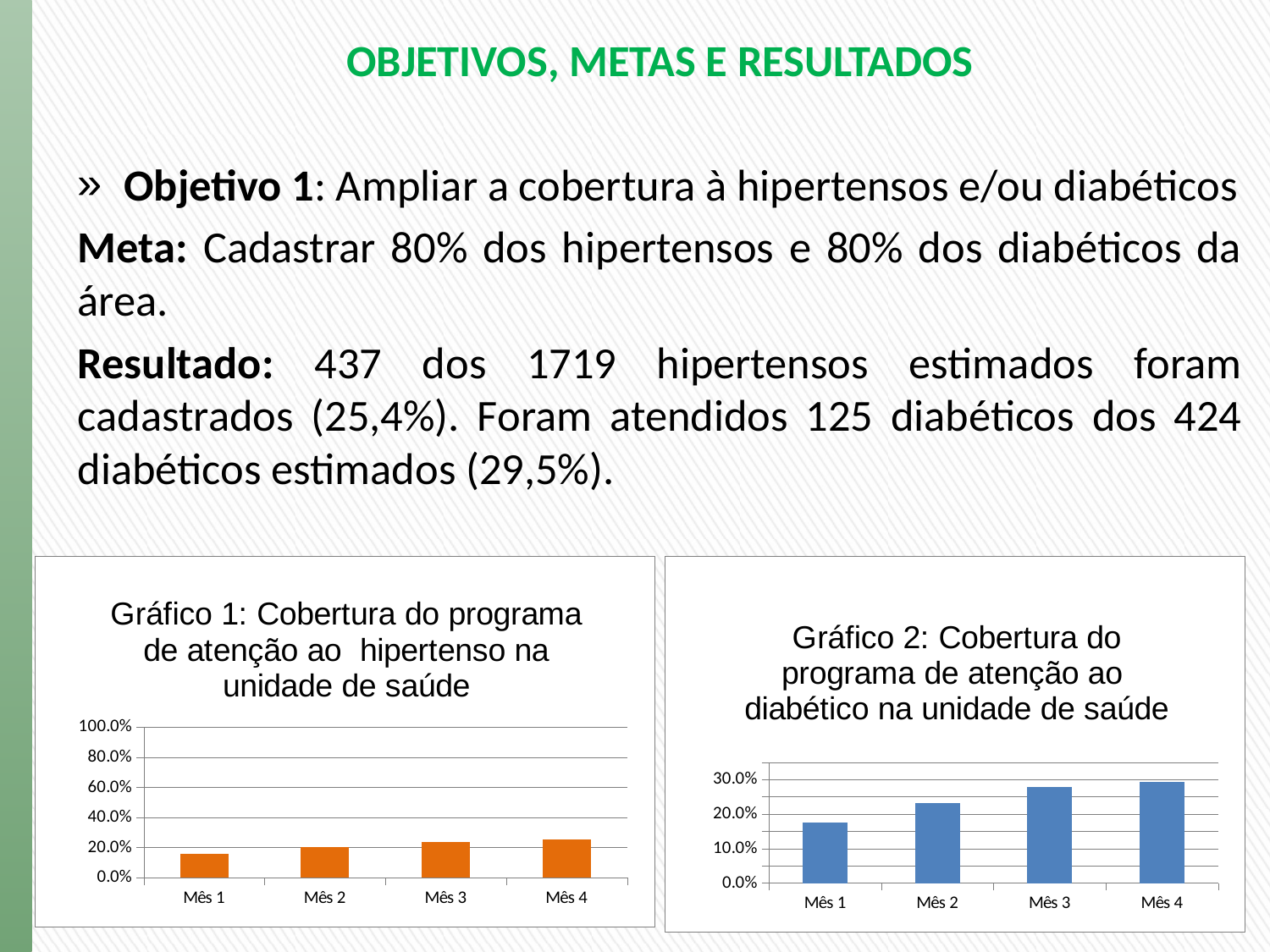
In Gráfico 2 (diabético), which month has the highest coverage? Mês 4 In Gráfico 2 (diabético), is the value for Mês 1 greater or less than 20.0%? less What kind of chart is Gráfico 1 (Cobertura do programa de atenção ao hipertenso)? bar chart What colour are the bars in Gráfico 1 (hipertenso)? orange In Gráfico 1 (hipertenso), is the value for Mês 4 greater or less than 20.0%? greater How many months (categories) are shown in Gráfico 2 (Cobertura do programa de atenção ao diabético)? 4 In Gráfico 2 (diabético), is the value for Mês 3 greater or less than 20.0%? greater In Gráfico 2 (diabético), do the values rise or fall from Mês 1 to Mês 4? rise In Gráfico 2 (diabético), which month has the lowest coverage? Mês 1 In Gráfico 1 (hipertenso), which month has the highest coverage? Mês 4 In Gráfico 1 (hipertenso), which month has the lowest coverage? Mês 1